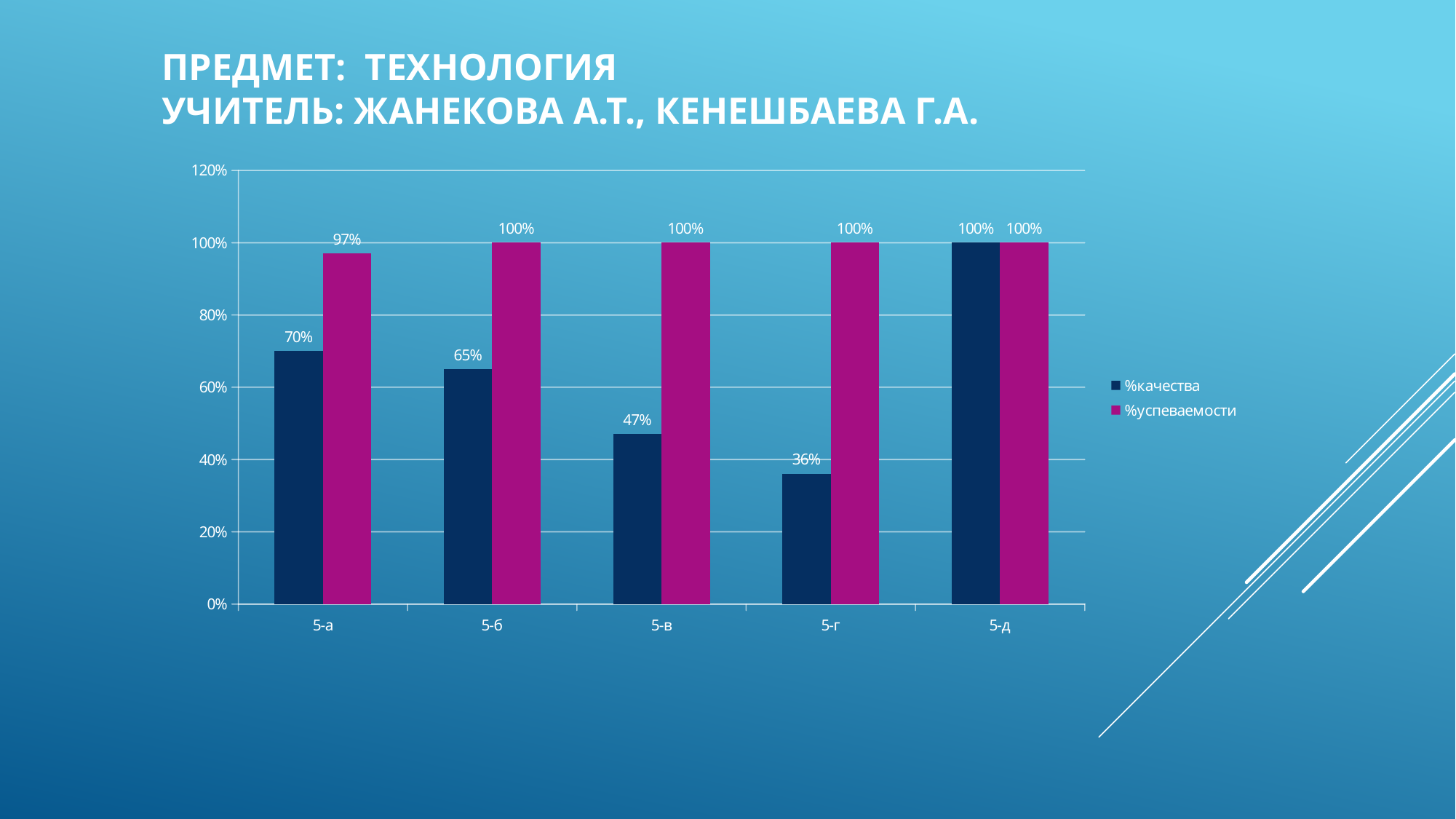
Which class has the lowest %качества value? 5-г Which is larger for class 5-б: %качества or %успеваемости? %успеваемости What is the difference between the %качества values for 5-а and 5-б? 5% Which colour represents %успеваемости in the chart? Magenta Which class has the highest %качества value? 5-д What is the %качества value for class 5-а? 70% What kind of chart is shown on the slide? Bar chart How many classes are shown on the x axis? 5 What is the %успеваемости value for class 5-а? 97% How many series does the legend list? 2 What is the %качества value for class 5-г? 36% What is the difference between %успеваемости and %качества for class 5-в? 53%